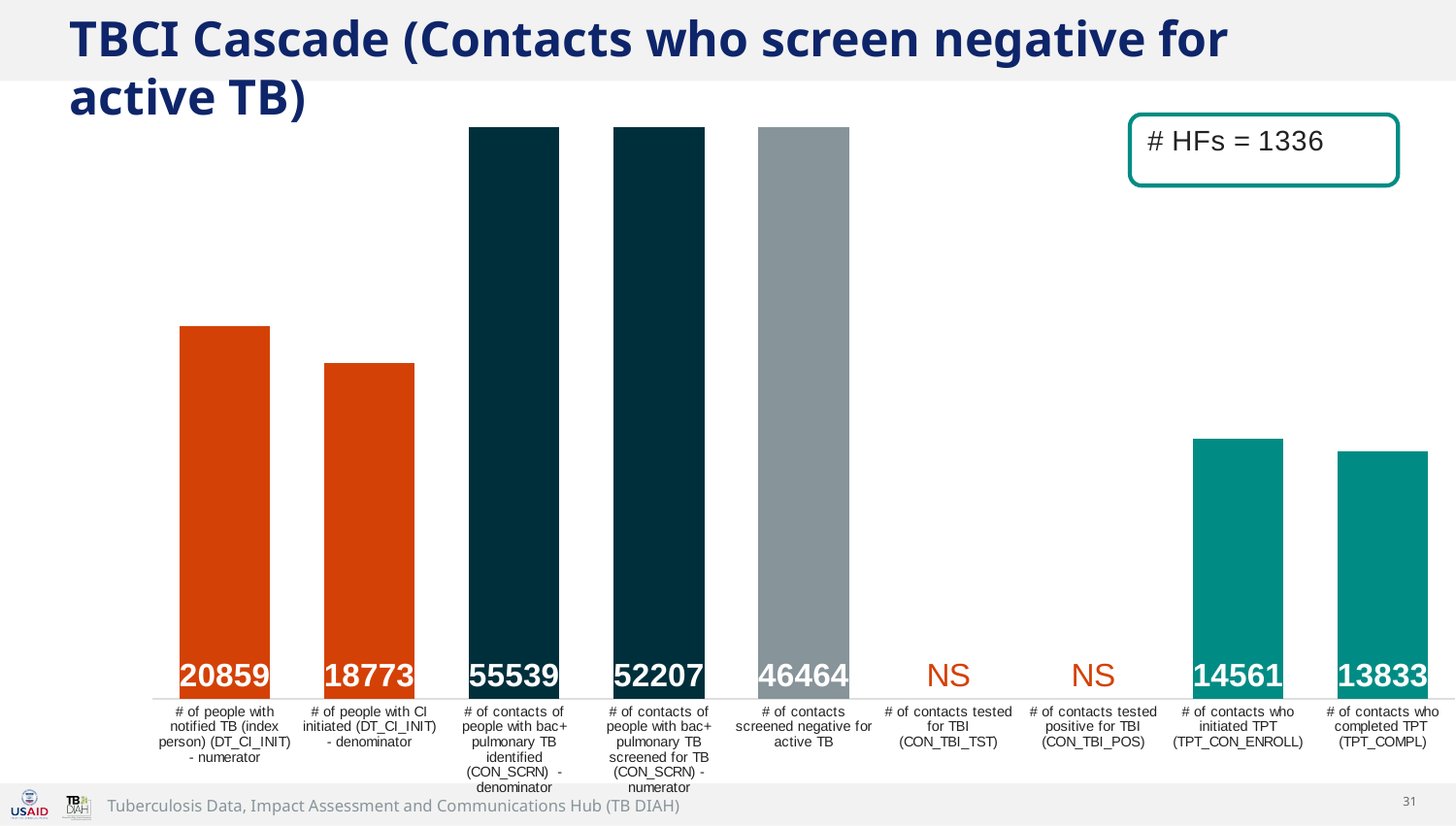
What is the value for '# of contacts screened negative for active TB'? 46464 Which category with a numeric value has the lowest value? # of contacts who completed TPT (TPT_COMPL) Which category has the highest value? # of contacts of people with bac+ pulmonary TB identified (CON_SCRN) - denominator What is the difference between '# of contacts who initiated TPT (TPT_CON_ENROLL)' and '# of contacts who completed TPT (TPT_COMPL)'? 728 How many categories are shown on the x axis? 9 What is shown for '# of contacts tested for TBI (CON_TBI_TST)'? NS What kind of chart is this? Bar chart What is the difference between '# of contacts of people with bac+ pulmonary TB identified (CON_SCRN) - denominator' and '# of contacts of people with bac+ pulmonary TB screened for TB (CON_SCRN) - numerator'? 3332 Which is larger: '# of people with notified TB (index person) (DT_CI_INIT) - numerator' or '# of people with CI initiated (DT_CI_INIT) - denominator'? # of people with notified TB (index person) (DT_CI_INIT) - numerator What is the value for '# of contacts who completed TPT (TPT_COMPL)'? 13833 What is the value for '# of people with notified TB (index person) (DT_CI_INIT) - numerator'? 20859 What number of health facilities (HFs) is stated in the box on the slide? 1336